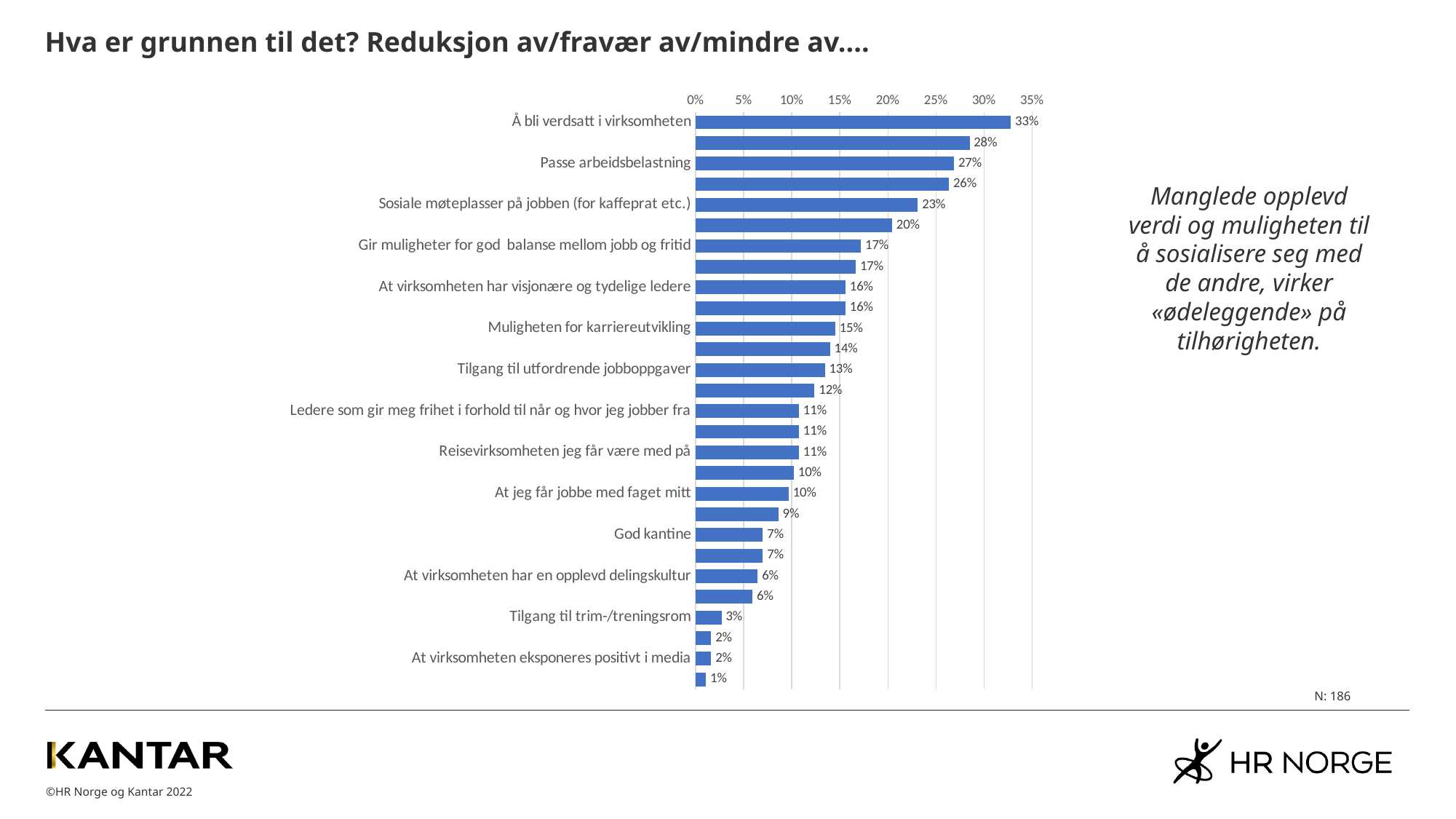
What is the value for "God kantine"? 7% What is the value for "Sosiale møteplasser på jobben (for kaffeprat etc.)"? 23% How many bars are plotted in the chart? 28 What is the value for "Tilgang til trim-/treningsrom"? 3% What is the sample size (N) shown on the slide? 186 Which category has the highest value? Å bli verdsatt i virksomheten What is the value for "Passe arbeidsbelastning"? 27% What kind of chart is shown on the slide? bar chart Is the value for "Gir muligheter for god balanse mellom jobb og fritid" greater or less than 15%? greater What is the difference between "Å bli verdsatt i virksomheten" and "Passe arbeidsbelastning"? 6% Which is larger: "Muligheten for karriereutvikling" or "Tilgang til utfordrende jobboppgaver"? Muligheten for karriereutvikling What is the value for "Å bli verdsatt i virksomheten"? 33%